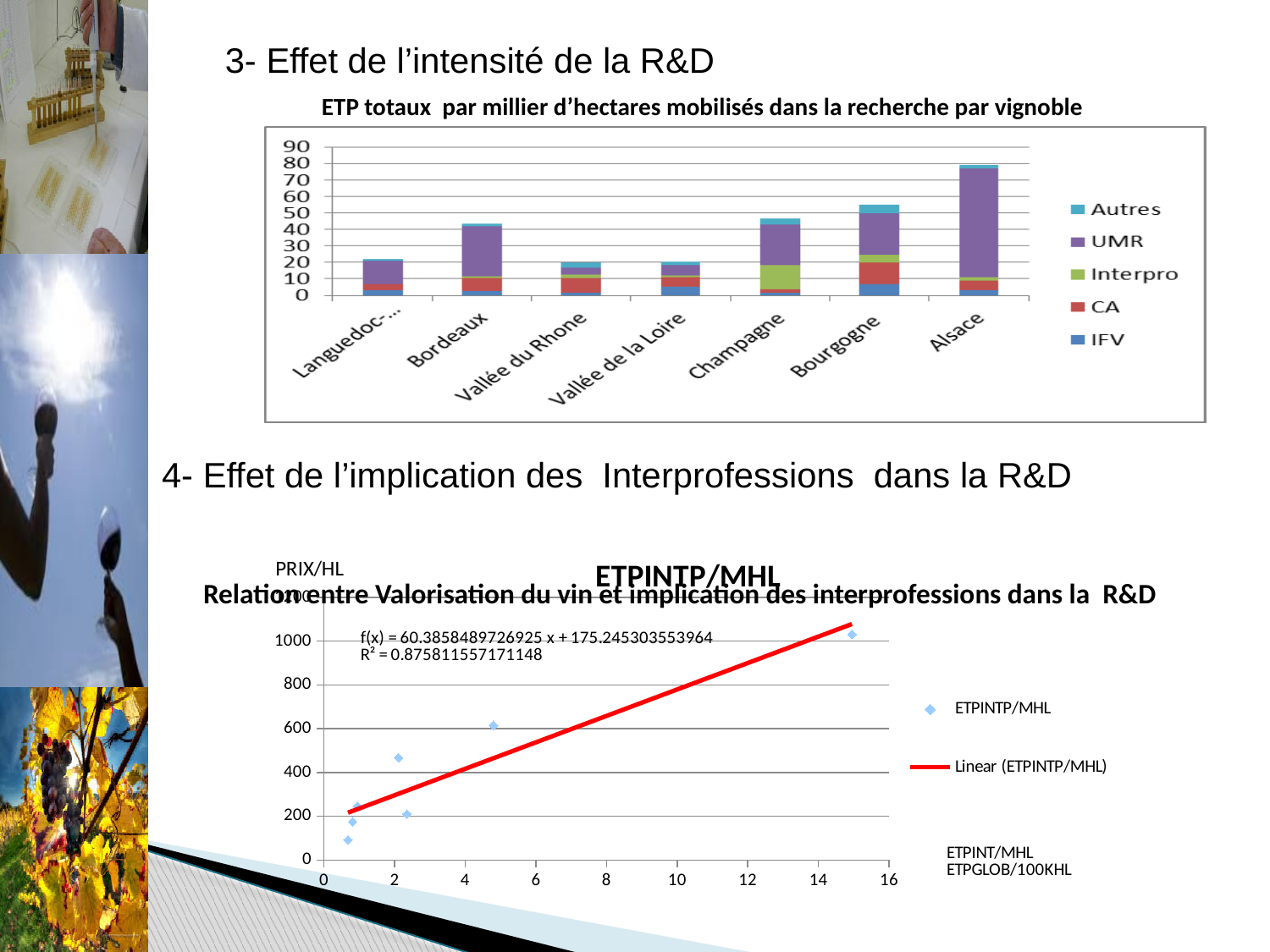
In the top chart (ETP totaux par millier d'hectares), which vignoble has the highest total bar? Alsace In the top chart (ETP totaux par millier d'hectares), how many series does the legend list? 5 What kind of chart is the top chart titled 'ETP totaux par millier d'hectares mobilisés dans la recherche par vignoble'? Stacked bar chart In the top chart (ETP totaux par millier d'hectares), which has the larger total bar, Bourgogne or Champagne? Bourgogne In the top chart (ETP totaux par millier d'hectares), which series is shown in purple in the legend? UMR In the top chart (ETP totaux par millier d'hectares), how many vignobles (categories) are shown on the x axis? 7 In the top chart (ETP totaux par millier d'hectares), is the total for Bordeaux greater or less than 50? less What kind of chart is the bottom chart titled 'Relation entre Valorisation du vin et implication des interprofessions dans la R&D'? Scatter chart In the bottom chart (Relation entre Valorisation du vin et implication des interprofessions), does the fitted linear trend line rise or fall along the x axis? Rise In the bottom chart (Relation entre Valorisation du vin et implication des interprofessions), how many entries does the legend list? 2 In the top chart (ETP totaux par millier d'hectares), is the total for Languedoc greater or less than 30? less In the top chart (ETP totaux par millier d'hectares), is the total for Alsace greater or less than 70? greater